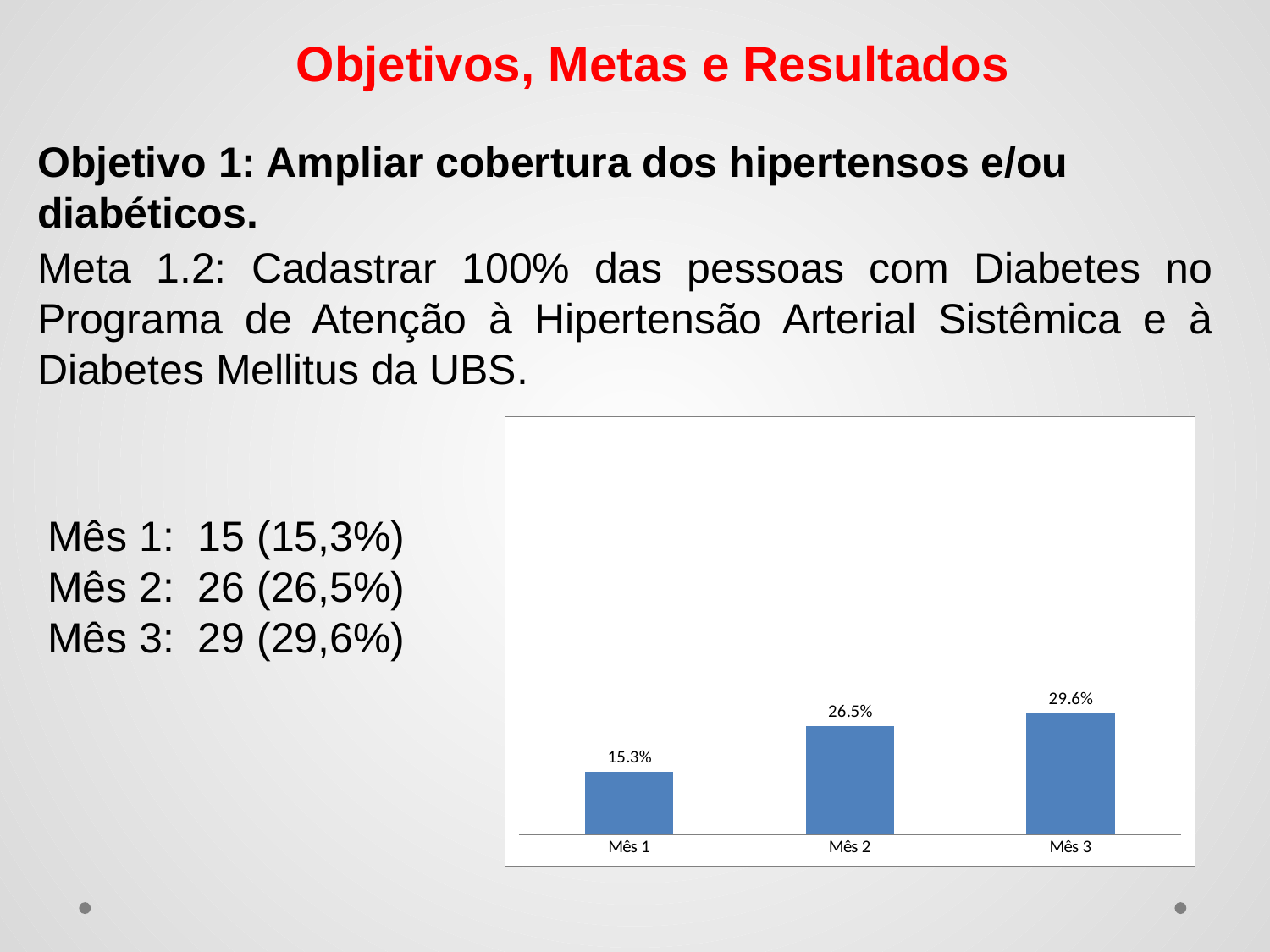
What is the value for Mês 3? 29.6% What colour are the bars in the chart? Blue Which category has the lowest value? Mês 1 How many categories are shown on the x axis? 3 What is the difference between the values for Mês 3 and Mês 1? 14.3% Which category has the highest value? Mês 3 What is the value for Mês 2? 26.5% What is the value for Mês 1? 15.3% What is the difference between the values for Mês 2 and Mês 1? 11.2% What kind of chart is shown on the slide? Bar chart Do the values rise or fall from Mês 1 to Mês 3? Rise Which is larger, the value for Mês 2 or the value for Mês 3? Mês 3